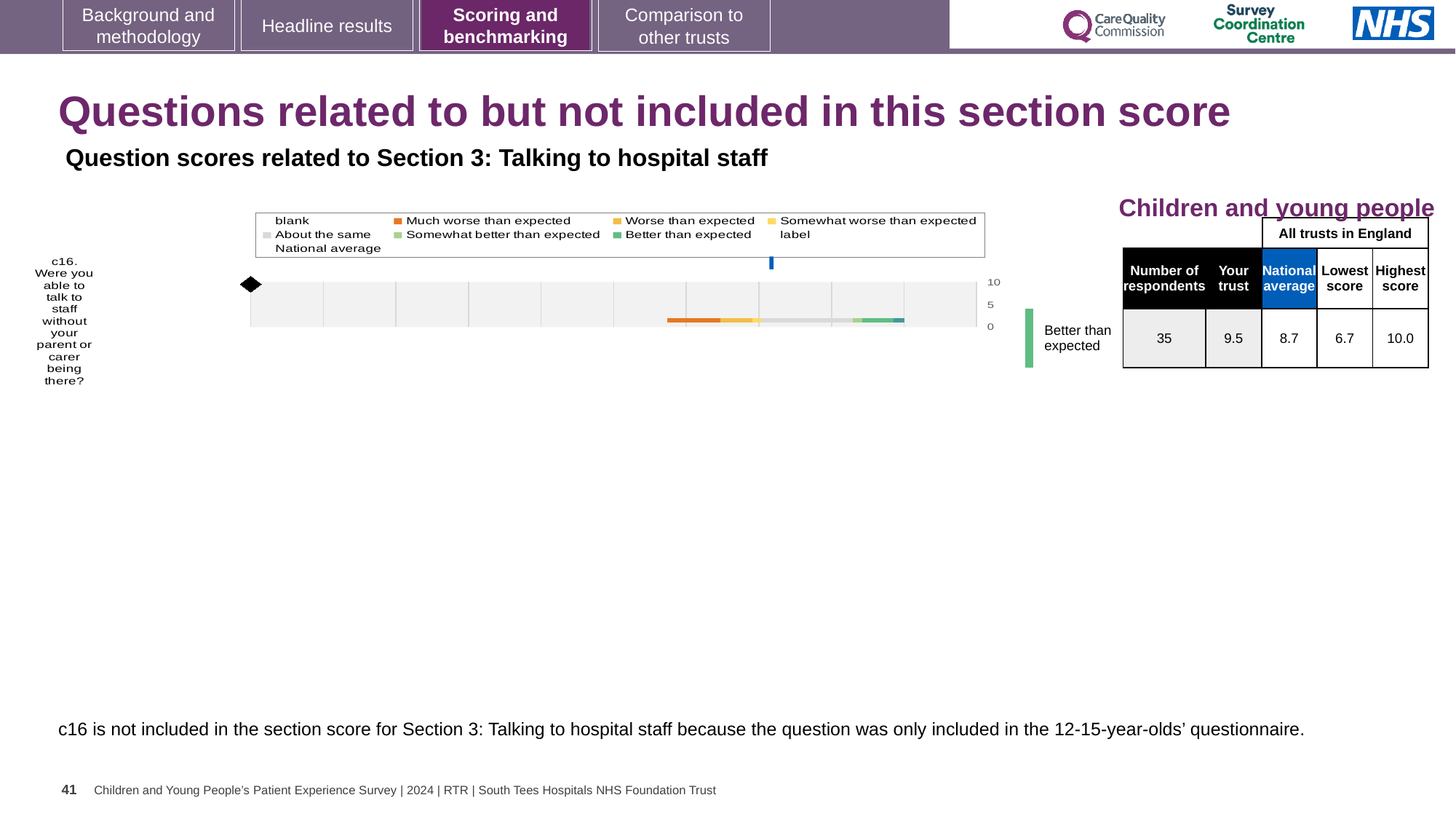
What is the difference between the 'Your trust' score and the national average for c16? 0.8 What is the highest score across all trusts in England for c16? 10.0 What benchmark category label is shown next to the c16 bar? Better than expected What is the lowest score across all trusts in England for c16? 6.7 What is the difference between the highest and lowest scores across all trusts for c16? 3.3 What is the national average score for c16 shown in the table beside the chart? 8.7 What kind of chart is shown on the slide? bar chart How many questions (categories) are plotted in the chart? 1 Which question is plotted in the chart? c16. Were you able to talk to staff without your parent or carer being there? How many respondents answered c16? 35 What is the 'Your trust' score for c16 shown in the table beside the chart? 9.5 Which is larger for c16, the 'Your trust' score or the national average? Your trust